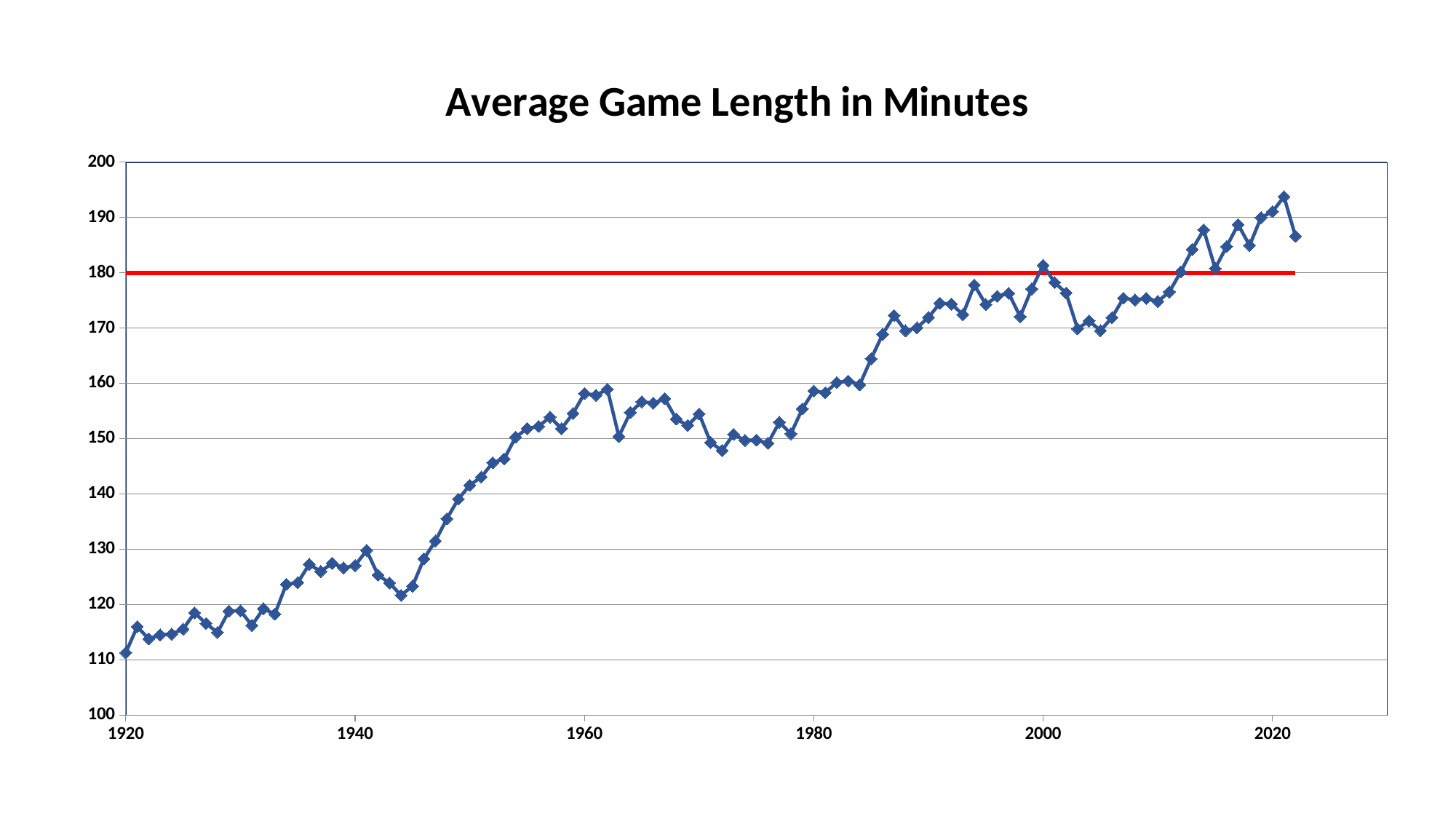
At what value on the y axis is the horizontal red line drawn? 180 Is the value for 1960 greater or less than 150? greater What is the title of the chart? Average Game Length in Minutes Is the value for 2020 greater or less than 180? greater Is the highest value on the line greater or less than 190? greater Which year has the lowest average game length? 1920 Which year has the larger value, 1940 or 1960? 1960 Overall, do the values rise or fall from 1920 to 2020? rise What kind of chart is shown on the slide? line chart